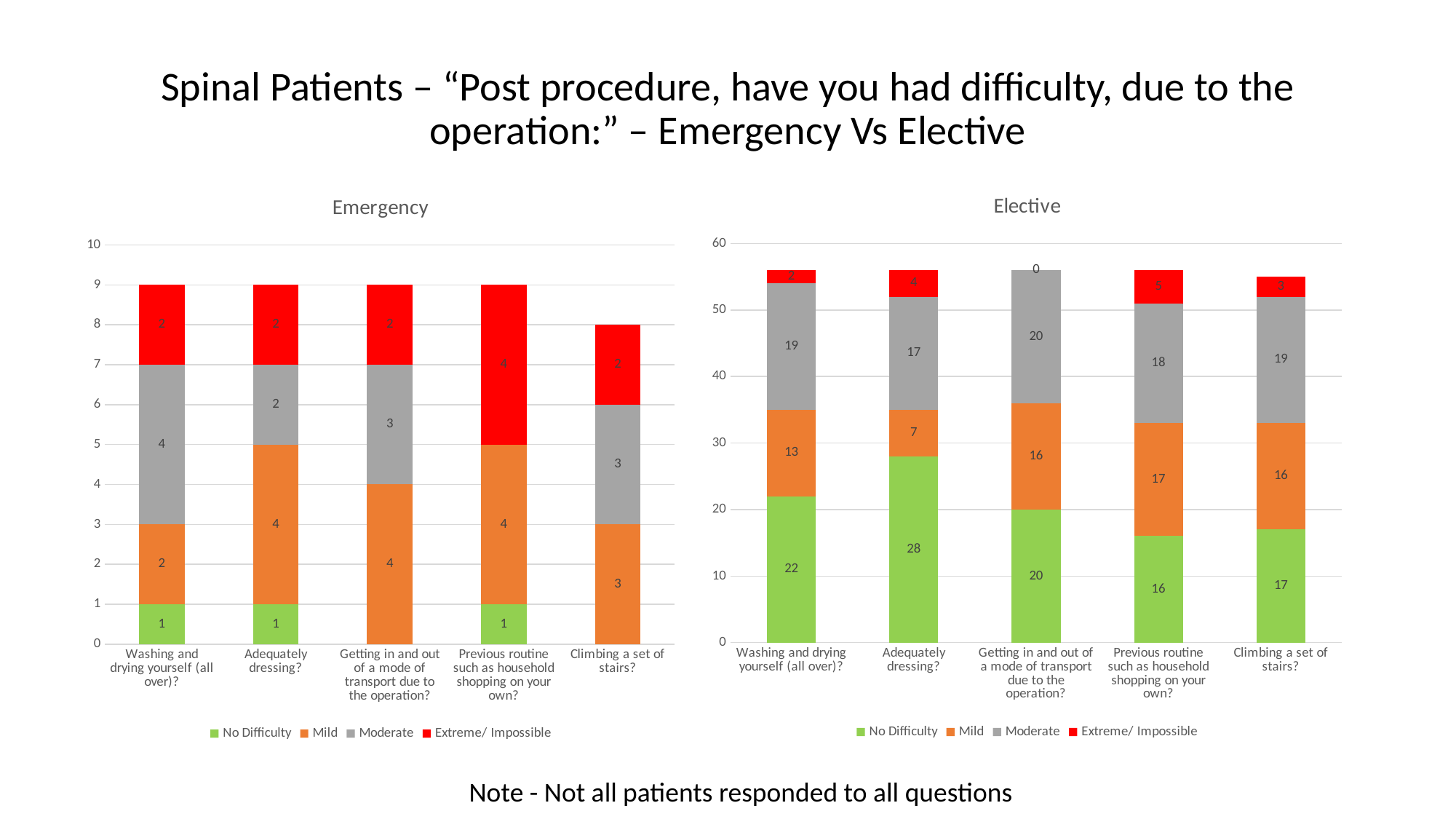
In the Elective chart, which has the larger Moderate value: "Getting in and out of a mode of transport due to the operation?" or "Adequately dressing?"? Getting in and out of a mode of transport due to the operation? In the Elective chart, which category has the highest No Difficulty value? Adequately dressing? In the Elective chart, what is the No Difficulty value for "Adequately dressing?"? 28 In the Elective chart, what is the difference between the Mild value for "Previous routine such as household shopping on your own?" and the Mild value for "Adequately dressing?"? 10 In the Emergency chart, what is the Extreme/ Impossible value for "Previous routine such as household shopping on your own?"? 4 In the Elective chart, which category has the lowest No Difficulty value? Previous routine such as household shopping on your own? In the Elective chart, what is the total of the stacked bar for "Washing and drying yourself (all over)?"? 56 How many series does the legend of the Emergency chart list? 4 What kind of chart is the Elective chart? Stacked bar chart In the Elective chart, what is the Extreme/ Impossible value for "Previous routine such as household shopping on your own?"? 5 In the Emergency chart, what is the total of the stacked bar for "Climbing a set of stairs?"? 8 In the Emergency chart, what is the Moderate value for "Washing and drying yourself (all over)?"? 4